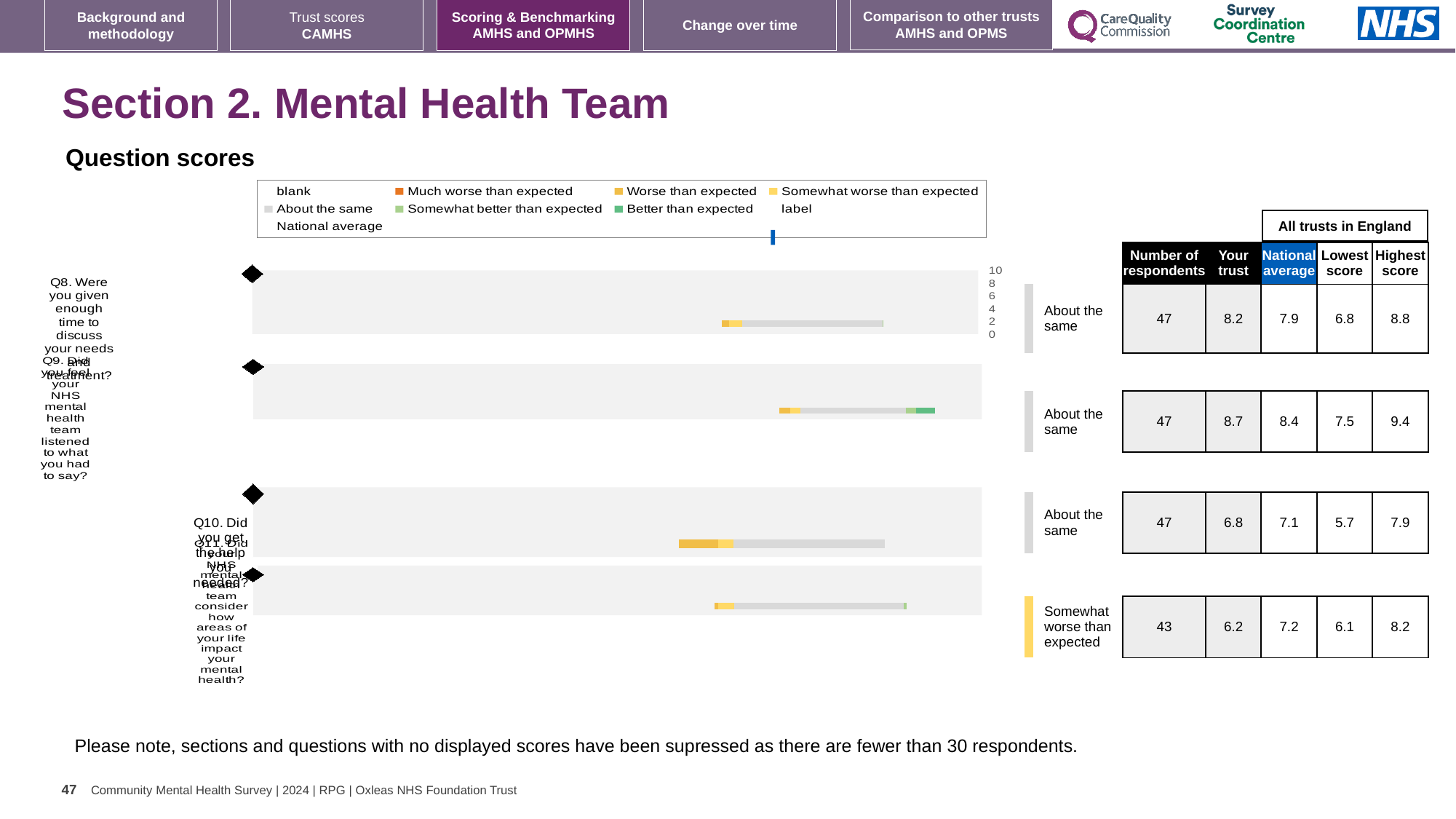
Which question has the highest 'Your trust' score? Q9 How many respondents are shown for Q11? 43 What is the 'Your trust' score shown for Q8? 8.2 How many entries does the legend of the question scores chart list? 9 How many questions (bars) are plotted in the question scores chart? 4 Which question has the lowest 'Your trust' score? Q11 What is the difference between the 'Your trust' score and the national average for Q8? 0.3 In the legend of the question scores chart, what colour represents 'Better than expected'? green In the legend of the question scores chart, what colour represents 'Much worse than expected'? orange What kind of chart is used to show the question scores on this slide? bar chart What is the national average shown for Q9? 8.4 Which is larger, the 'Your trust' score for Q9 or for Q10? Q9